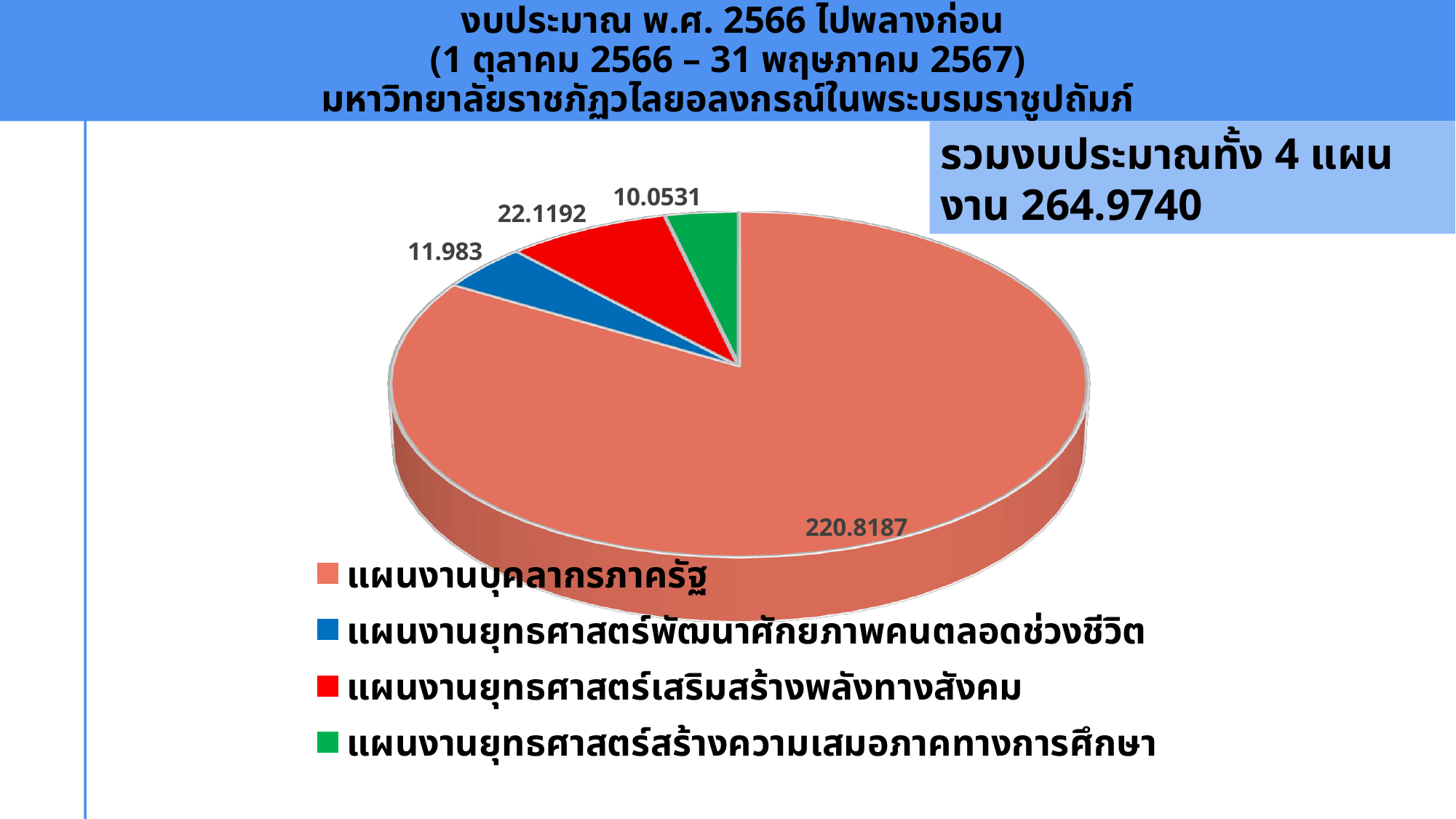
What is the value for แผนงานบุคลากรภาครัฐ? 220.8187 What is the value for แผนงานยุทธศาสตร์พัฒนาศักยภาพคนตลอดช่วงชีวิต? 11.983 What is the total budget across all 4 plans as stated on the slide? 264.9740 What is the value for แผนงานยุทธศาสตร์เสริมสร้างพลังทางสังคม? 22.1192 Which category has the largest slice of the pie? แผนงานบุคลากรภาครัฐ What is the value for แผนงานยุทธศาสตร์สร้างความเสมอภาคทางการศึกษา? 10.0531 What kind of chart is shown on the slide? pie chart Which category has the smallest slice of the pie? แผนงานยุทธศาสตร์สร้างความเสมอภาคทางการศึกษา What is the difference between the values for แผนงานยุทธศาสตร์เสริมสร้างพลังทางสังคม and แผนงานยุทธศาสตร์พัฒนาศักยภาพคนตลอดช่วงชีวิต? 10.1362 What colour is the slice for แผนงานยุทธศาสตร์สร้างความเสมอภาคทางการศึกษา? green Which is larger: แผนงานยุทธศาสตร์เสริมสร้างพลังทางสังคม or แผนงานยุทธศาสตร์พัฒนาศักยภาพคนตลอดช่วงชีวิต? แผนงานยุทธศาสตร์เสริมสร้างพลังทางสังคม How many categories does the pie chart have? 4